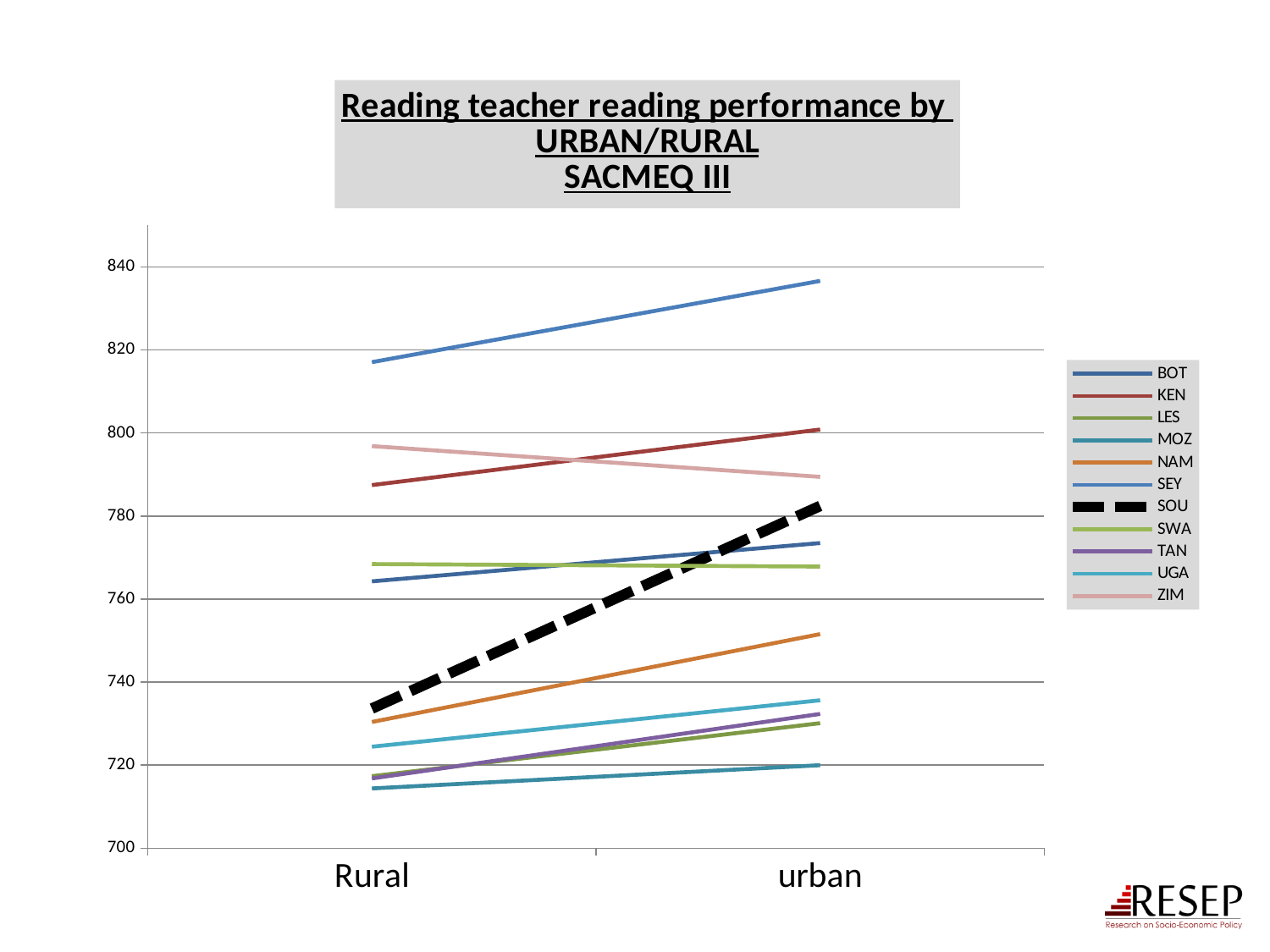
Which series has the lowest value at urban? MOZ Which series has the highest value at urban? SEY Is the value for NAM at urban greater or less than 740? greater Does the ZIM line rise or fall from Rural to urban? fall At Rural, which is larger, the value for SEY or the value for KEN? SEY Which series is drawn with a thick black dashed line? SOU Is the value for SEY at urban greater or less than 820? greater Does the SOU line rise or fall from Rural to urban? rise What kind of chart is shown on the slide? line chart How many series does the legend list? 11 How many categories are shown on the x axis? 2 Is the value for SOU at Rural greater or less than 740? less